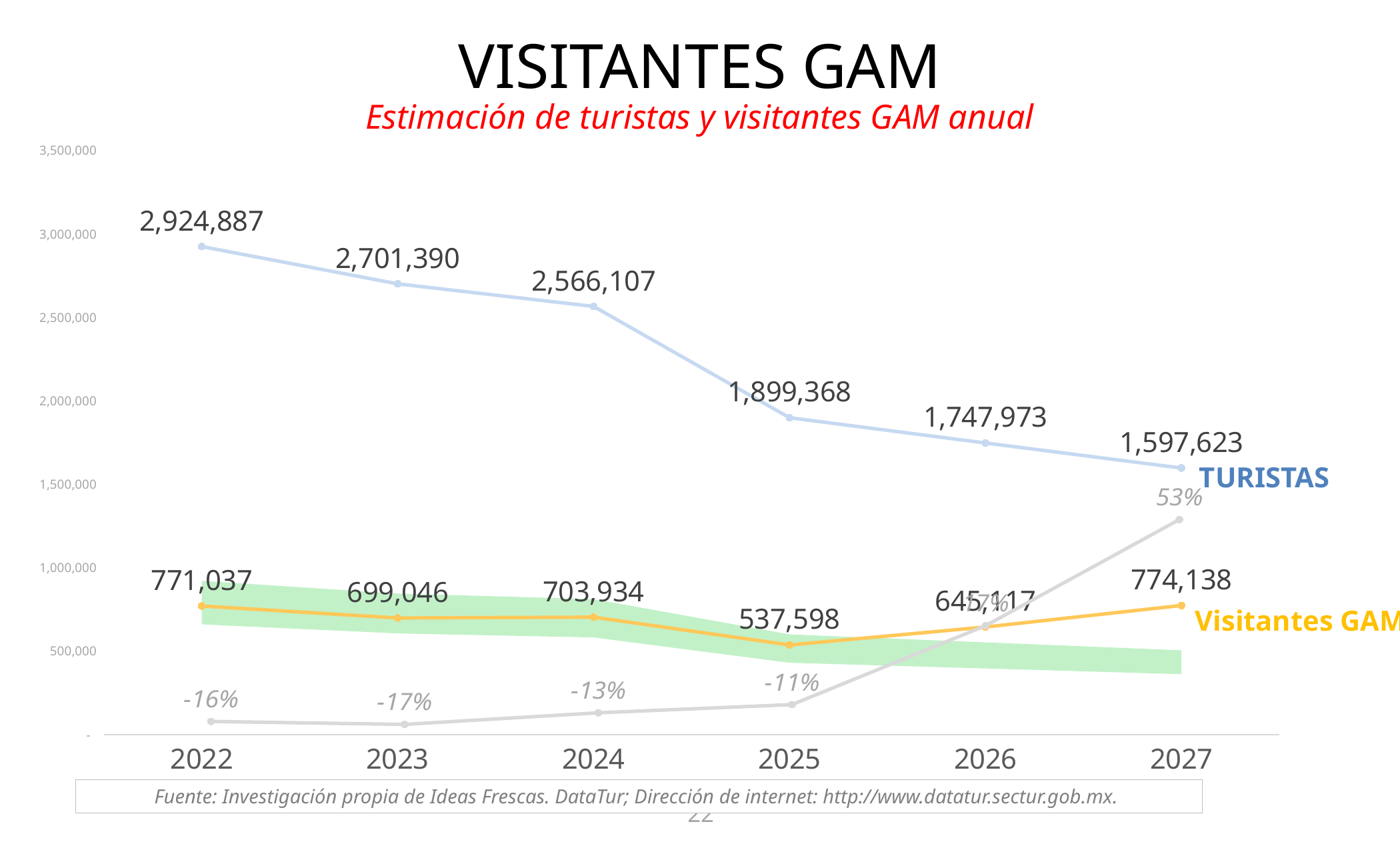
Does the TURISTAS line rise or fall from 2022 to 2027? Fall What is the TURISTAS value for 2022? 2,924,887 What is the TURISTAS value for 2027? 1,597,623 What is the Visitantes GAM value for 2023? 699,046 What is the difference between the Visitantes GAM values for 2027 and 2025? 236,540 How many years are shown on the x axis? 6 What kind of chart is this? Line chart Which is larger, the TURISTAS value for 2025 or the TURISTAS value for 2024? 2024 What is the Visitantes GAM value for 2025? 537,598 In which year is the TURISTAS value highest? 2022 What is the difference between the TURISTAS values for 2022 and 2027? 1,327,264 In which year is the Visitantes GAM value lowest? 2025